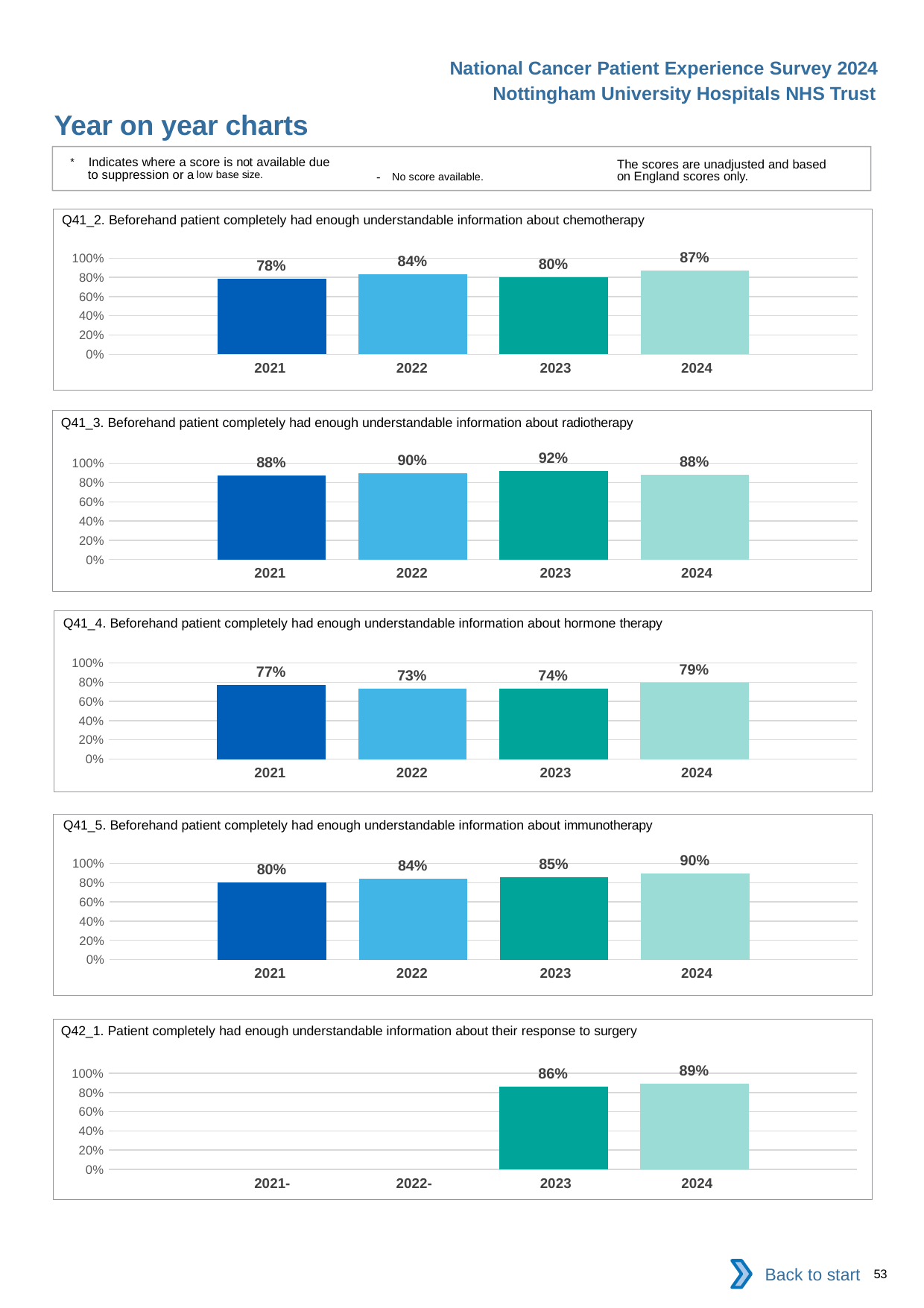
In the Q41_4 chart about hormone therapy, which year has the lowest value? 2022 In the Q41_5 chart about immunotherapy, what is the difference between the 2024 and 2021 values? 10 percentage points How many charts are shown on the slide? 5 In the Q41_5 chart about immunotherapy, do the values rise or fall from 2021 to 2024? rise In the Q42_1 chart about response to surgery, which is larger, the 2023 value or the 2024 value? 2024 What kind of chart is the Q41_2 chart about chemotherapy? bar chart In the Q41_2 chart about chemotherapy, what is the value for 2022? 84% In the Q41_2 chart about chemotherapy, which year has the highest value? 2024 In the Q41_3 chart about radiotherapy, what is the difference between the 2023 and 2021 values? 4 percentage points In the Q41_4 chart about hormone therapy, what is the value for 2024? 79% In the Q41_3 chart about radiotherapy, what is the value for 2023? 92% In the Q42_1 chart about response to surgery, how many years have a bar plotted? 2